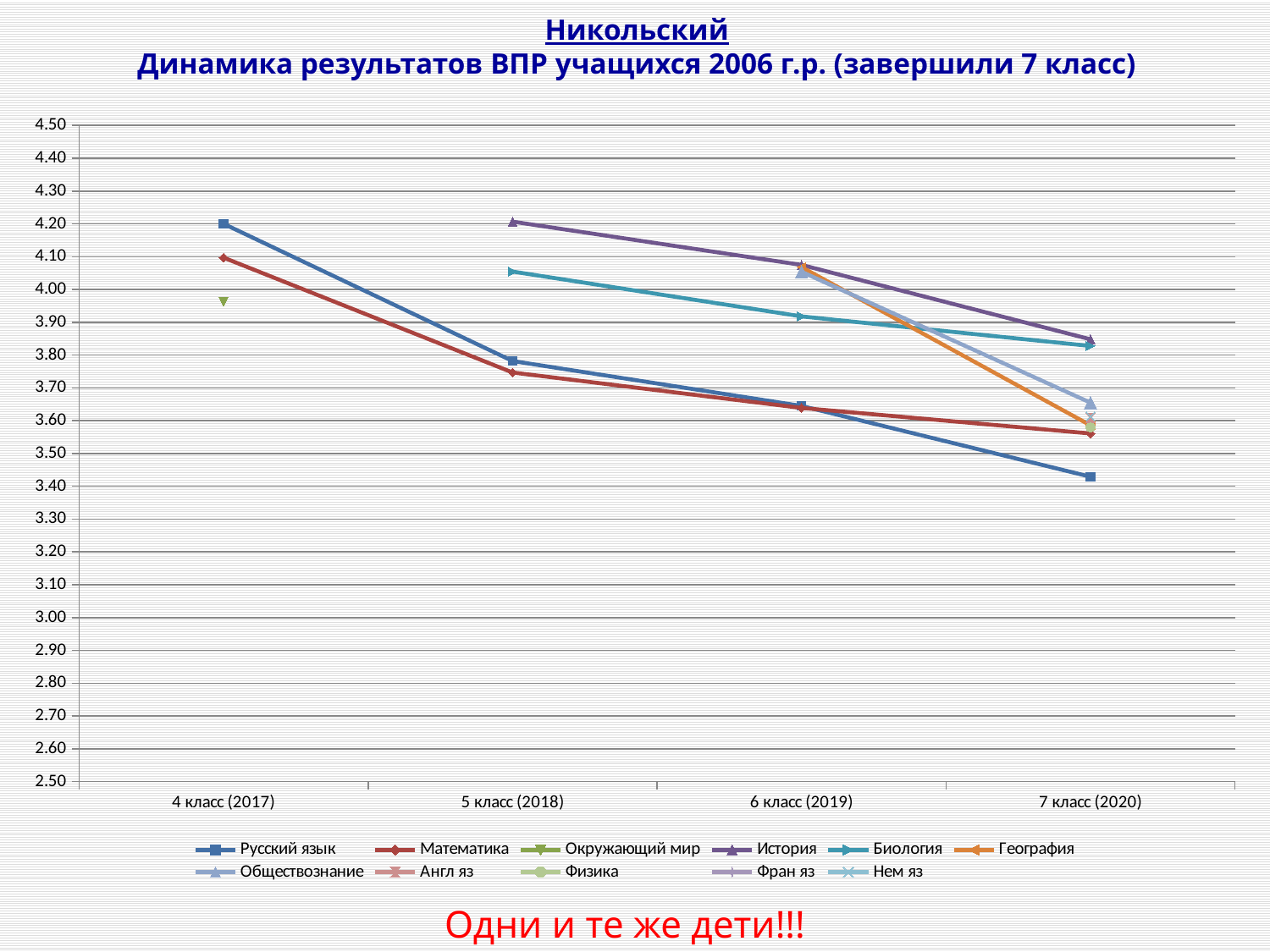
How many categories are shown on the x axis? 4 Is the value for Русский язык at 7 класс (2020) greater or less than 3.50? less Is the value for История at 5 класс (2018) greater or less than 4.10? greater What kind of chart is shown on the slide? line chart Is the value for Окружающий мир at 4 класс (2017) greater or less than 4.00? less How many series does the legend list? 11 At 4 класс (2017), which is higher: Русский язык or Математика? Русский язык Does the value for Русский язык rise or fall from 4 класс (2017) to 7 класс (2020)? fall Does the value for Математика rise or fall across the x axis? fall Which series has the lowest value at 7 класс (2020)? Русский язык Which series has the highest value at 7 класс (2020)? История